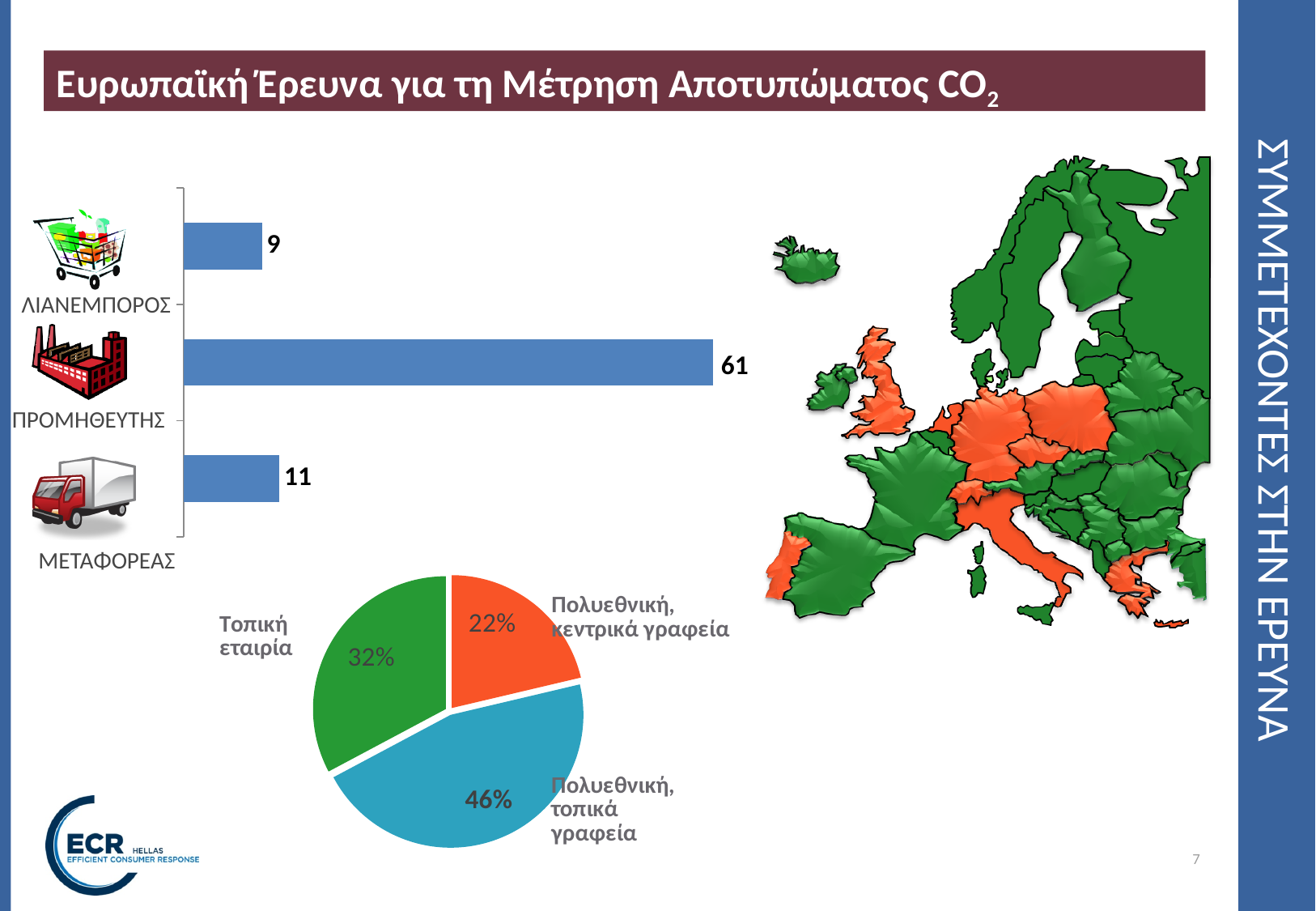
In the bar chart, which category has the highest value? ΠΡΟΜΗΘΕΥΤΗΣ In the pie chart, which slice is the smallest? Πολυεθνική, κεντρικά γραφεία In the pie chart, what share does 'Πολυεθνική, τοπικά γραφεία' have? 46% What kind of chart is the chart on the left with ΛΙΑΝΕΜΠΟΡΟΣ, ΠΡΟΜΗΘΕΥΤΗΣ and ΜΕΤΑΦΟΡΕΑΣ? Bar chart In the bar chart, what is the value for ΠΡΟΜΗΘΕΥΤΗΣ? 61 In the bar chart, what is the value for ΜΕΤΑΦΟΡΕΑΣ? 11 In the pie chart, what share does 'Τοπική εταιρία' have? 32% In the bar chart, what is the difference between the values for ΠΡΟΜΗΘΕΥΤΗΣ and ΜΕΤΑΦΟΡΕΑΣ? 50 In the bar chart, which is larger: the value for ΜΕΤΑΦΟΡΕΑΣ or the value for ΛΙΑΝΕΜΠΟΡΟΣ? ΜΕΤΑΦΟΡΕΑΣ In the bar chart, what is the value for ΛΙΑΝΕΜΠΟΡΟΣ? 9 How many categories does the bar chart show? 3 In the bar chart, which category has the lowest value? ΛΙΑΝΕΜΠΟΡΟΣ